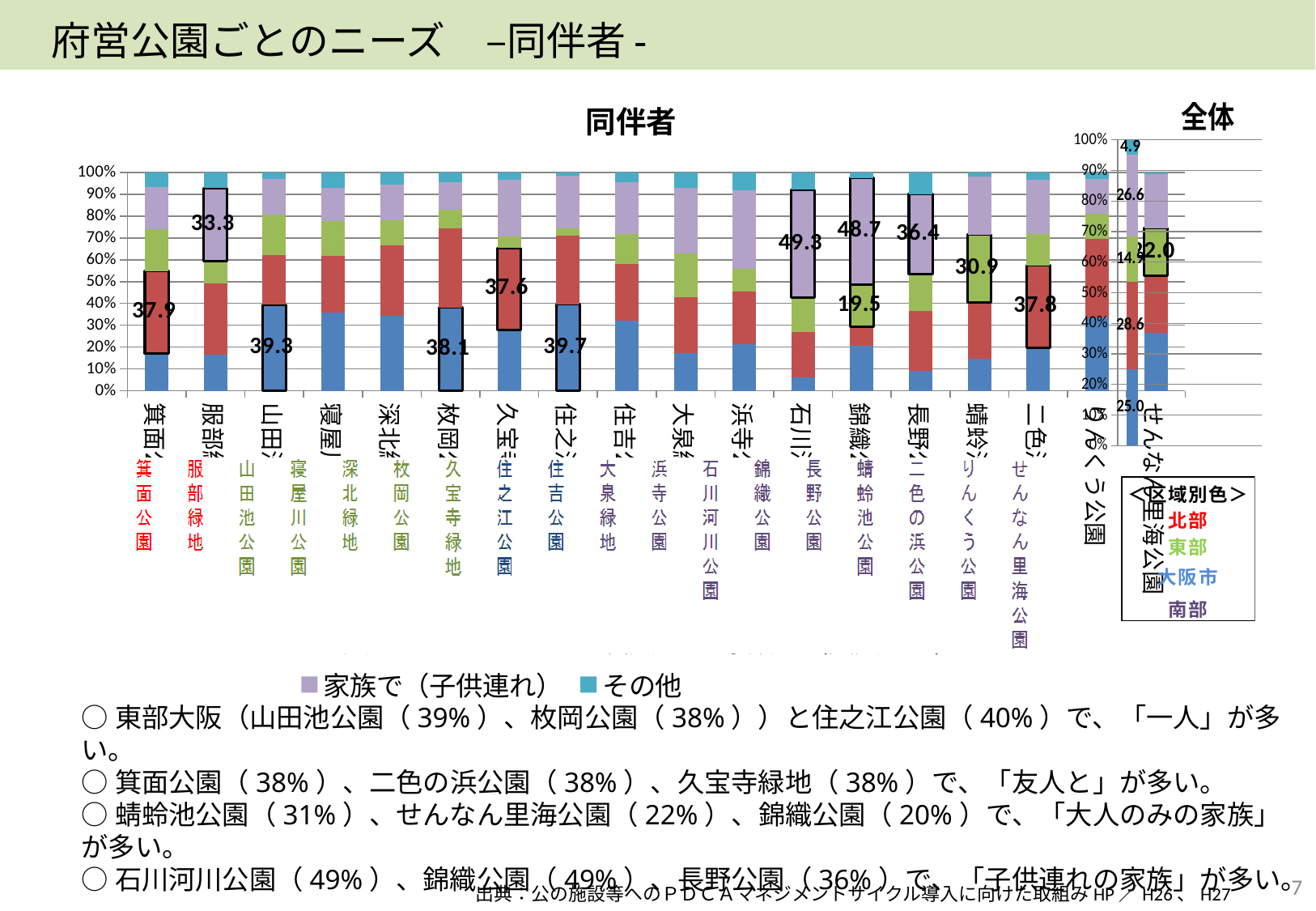
In the 同伴者 chart, what value is labelled on the highlighted segment for 山田池公園? 39.3 In the 同伴者 chart, is the bottom blue segment for 寝屋川公園 greater or less than 30%? greater In the 同伴者 chart, what value is labelled on the highlighted green segment for 蜻蛉池公園? 30.9 In the 同伴者 chart, how many parks (bars) are plotted? 18 In the 同伴者 chart, what kind of chart is shown? Stacked bar chart In the 同伴者 chart, what value is labelled on the highlighted 家族で（子供連れ） segment for 石川河川公園? 49.3 In the 同伴者 chart, among the labelled 家族で（子供連れ） values (服部緑地, 石川河川公園, 錦織公園, 長野公園), which park has the highest? 石川河川公園 In the 同伴者 chart, what value is labelled on the highlighted segment for 箕面公園? 37.9 In the 同伴者 chart, which is larger: the labelled 家族で（子供連れ） value for 石川河川公園 or for 長野公園? 石川河川公園 In the legend shown below the 同伴者 chart, what colour represents 家族で（子供連れ）? Purple In the 同伴者 chart, what is the difference between the labelled 家族で（子供連れ） values for 石川河川公園 (49.3) and 長野公園 (36.4)? 12.9 In the 同伴者 chart, what value is labelled on the highlighted segment for 住之江公園? 39.7